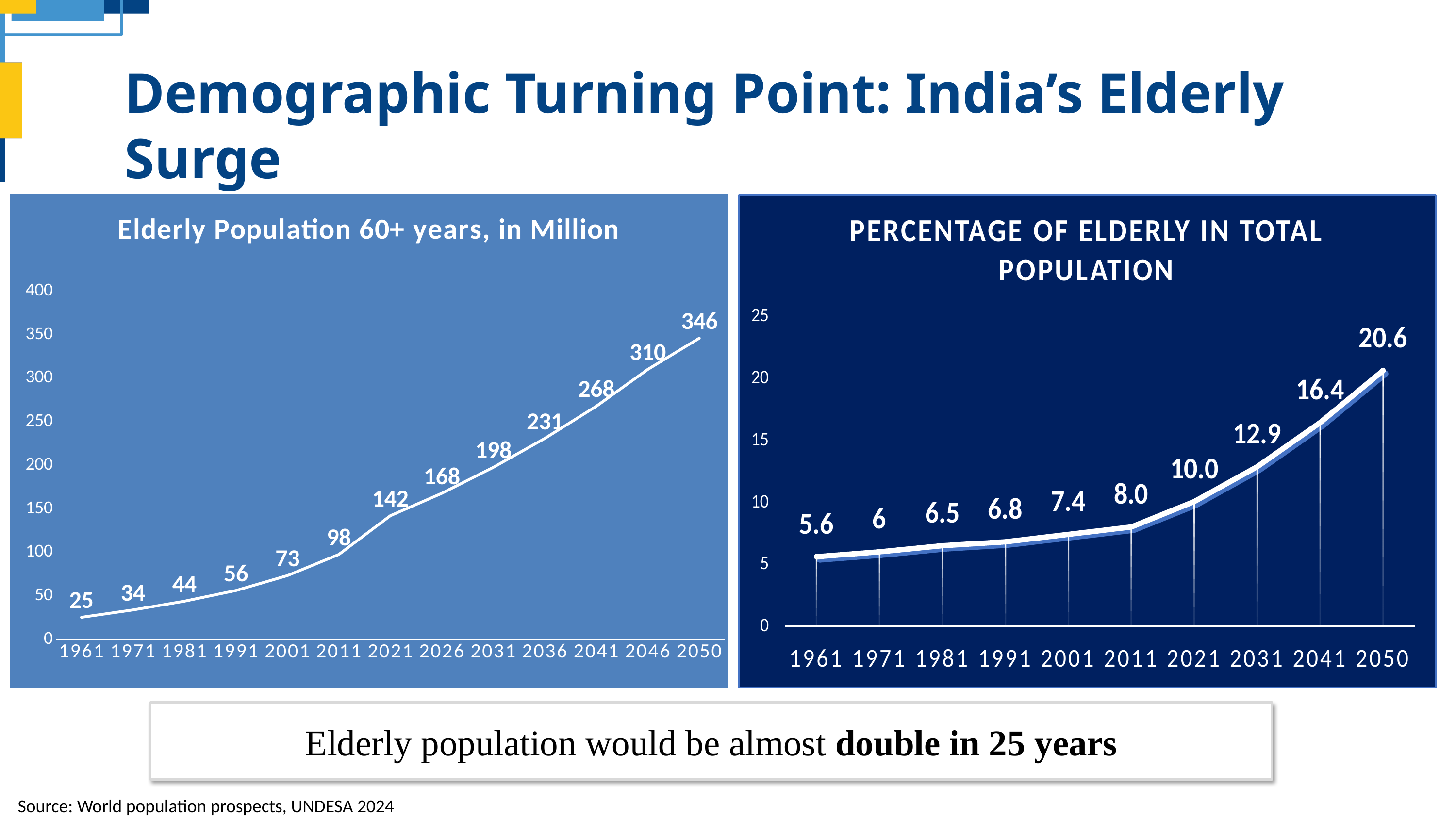
In the 'Elderly Population 60+ years, in Million' chart, which year has the lowest value? 1961 In the 'PERCENTAGE OF ELDERLY IN TOTAL POPULATION' chart, what is the value for 2031? 12.9 In the 'PERCENTAGE OF ELDERLY IN TOTAL POPULATION' chart, how many years are plotted on the x axis? 10 In the 'Elderly Population 60+ years, in Million' chart, do the values rise or fall from 1961 to 2050? rise In the 'PERCENTAGE OF ELDERLY IN TOTAL POPULATION' chart, which year has the highest value? 2050 What kind of chart is the 'Elderly Population 60+ years, in Million' chart? line chart In the 'PERCENTAGE OF ELDERLY IN TOTAL POPULATION' chart, which is larger, the value for 2011 or the value for 2021? 2021 In the 'Elderly Population 60+ years, in Million' chart, what is the value for 2021? 142 In the 'Elderly Population 60+ years, in Million' chart, how many years are plotted on the x axis? 13 In the 'Elderly Population 60+ years, in Million' chart, what is the difference between the values for 2050 and 2026? 178 In the 'Elderly Population 60+ years, in Million' chart, what is the value for 2050? 346 In the 'PERCENTAGE OF ELDERLY IN TOTAL POPULATION' chart, what is the value for 1961? 5.6